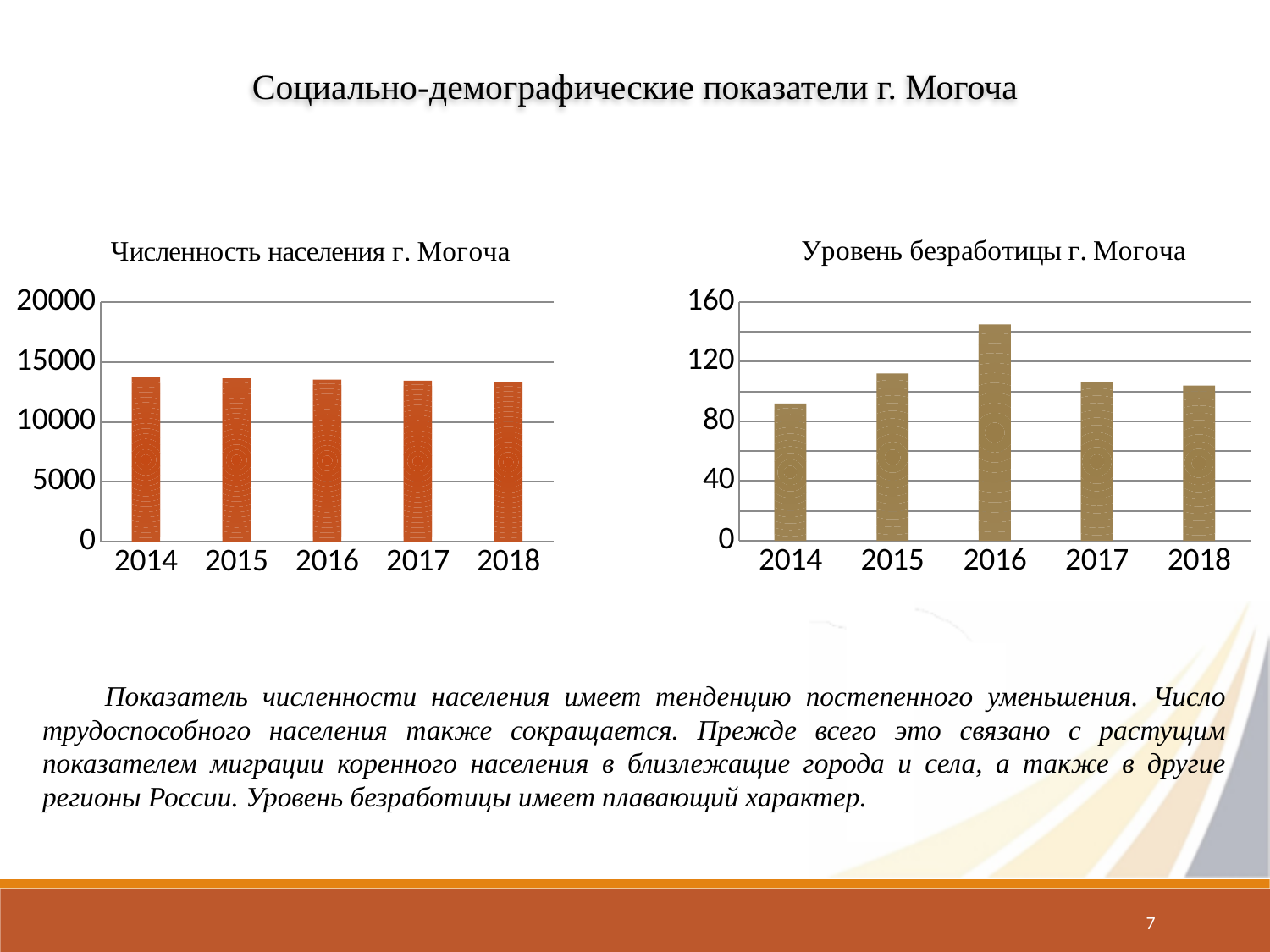
On the "Уровень безработицы г. Могоча" chart, is the value for 2014 greater or less than 120? less What is the title of the chart on the left side of the slide? Численность населения г. Могоча On the "Уровень безработицы г. Могоча" chart, is the value for 2016 greater or less than 120? greater What is the title of the chart on the right side of the slide? Уровень безработицы г. Могоча On the "Численность населения г. Могоча" chart, is the value for 2014 greater or less than 10000? greater On the "Численность населения г. Могоча" chart, do the values rise or fall from 2014 to 2018? fall What kind of chart is the "Численность населения г. Могоча" chart? bar chart On the "Уровень безработицы г. Могоча" chart, which year has the highest value? 2016 On the "Уровень безработицы г. Могоча" chart, which year has the lowest value? 2014 How many years are shown on the "Уровень безработицы г. Могоча" chart? 5 On the "Уровень безработицы г. Могоча" chart, which is larger, the value for 2015 or the value for 2014? 2015